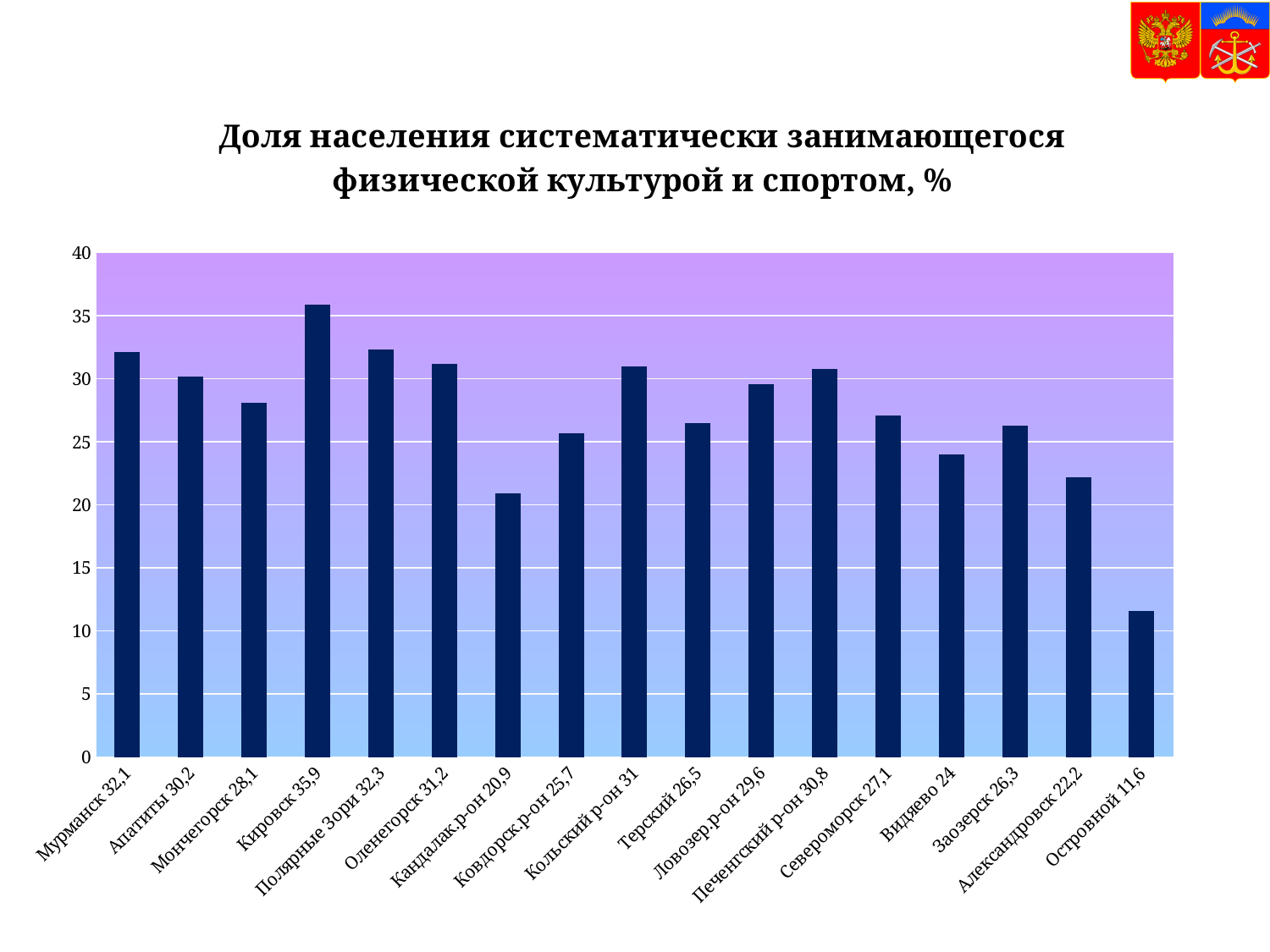
What kind of chart is shown on the slide? bar chart What is the value for Кировск? 35,9 Which category has the highest value? Кировск What is the value for Кандалак.р-он? 20,9 What is the title of the chart? Доля населения систематически занимающегося физической культурой и спортом, % What is the difference between the values for Мурманск and Апатиты? 1,9 Is the value for Видяево greater or less than 25? less What is the value for Островной? 11,6 Which category has the lowest value? Островной What is the difference between the values for Кировск and Островной? 24,3 Which is larger, the value for Полярные Зори or the value for Оленегорск? Полярные Зори How many categories are shown on the x axis? 17